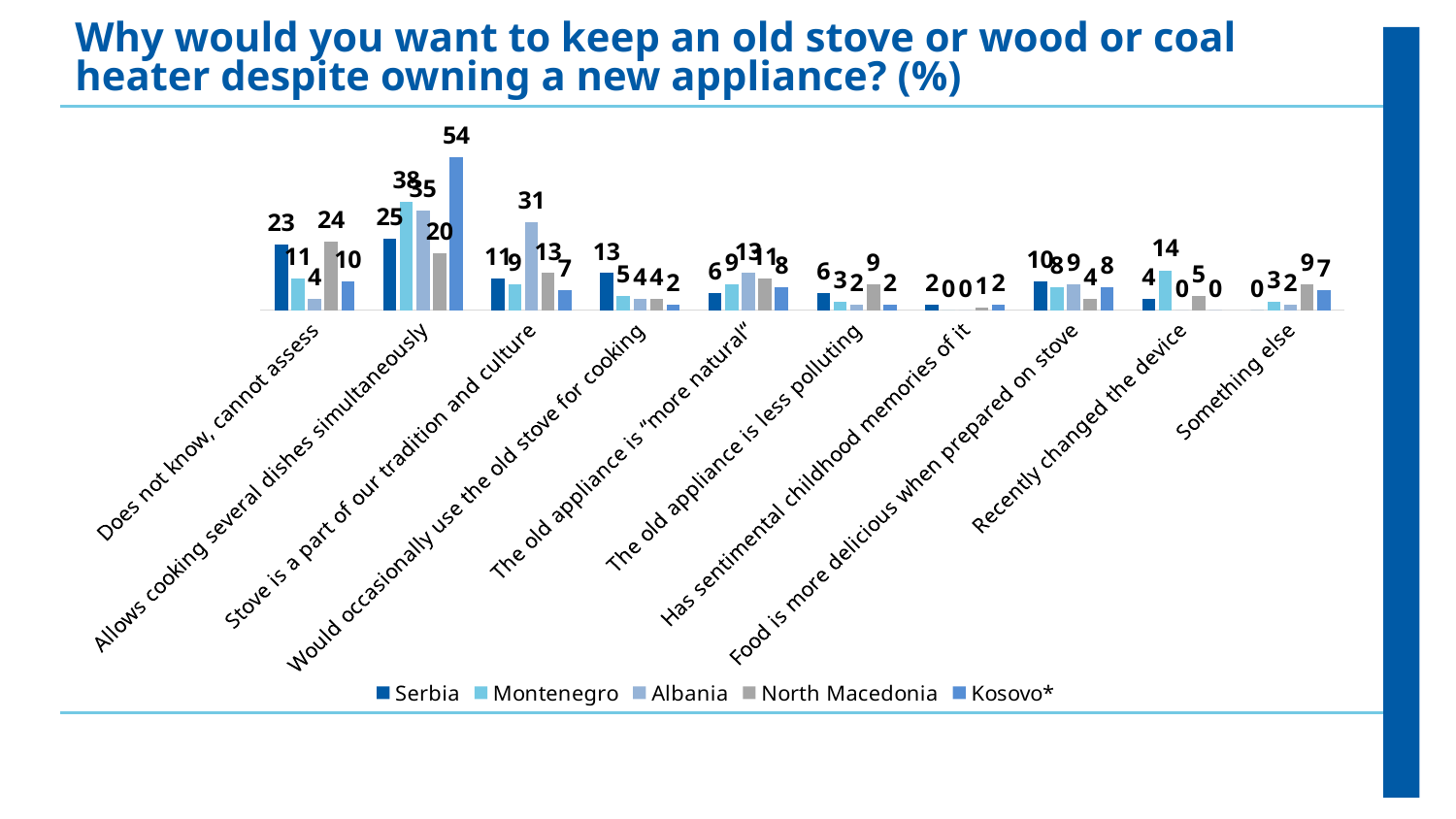
Which country has the highest value for "Allows cooking several dishes simultaneously"? Kosovo* How many series does the legend list? 5 What is the difference between the Kosovo* value and the Serbia value for "Allows cooking several dishes simultaneously"? 29 What is the value for Kosovo* for "Allows cooking several dishes simultaneously"? 54 What kind of chart is shown on the slide? bar chart For "Would occasionally use the old stove for cooking", which is larger: the value for Serbia or the value for Kosovo*? Serbia How many categories are shown on the x axis? 10 What is the value for North Macedonia for "Does not know, cannot assess"? 24 Which country has the lowest value for "Does not know, cannot assess"? Albania What is the value for Montenegro for "Recently changed the device"? 14 Which series is shown in the darkest blue colour in the legend? Serbia What is the value for Albania for "Stove is a part of our tradition and culture"? 31